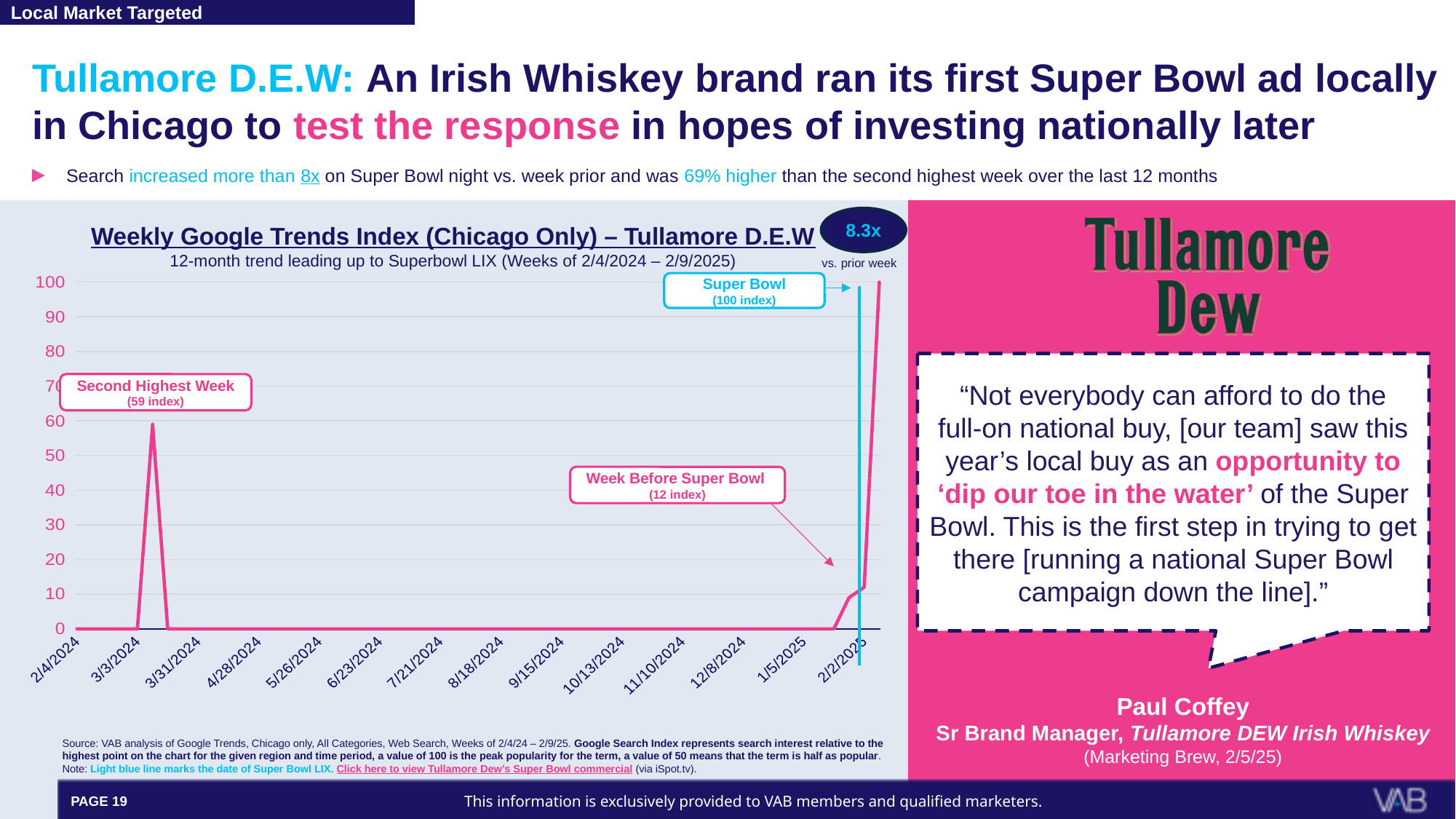
What is the index value for the week before the Super Bowl? 12 Which week has the highest Google Trends index value? Super Bowl week What is the difference between the Super Bowl week index and the second highest week index? 41 How many date labels are shown on the x axis? 14 What does the light blue vertical line on the chart mark? The date of Super Bowl LIX What is the index value for the second highest week? 59 What is the difference between the Super Bowl week index and the week before the Super Bowl? 88 How did the index values change between 4/28/2024 and 12/8/2024? Stayed flat near 0 Which is larger: the index for the second highest week or the index for the week before the Super Bowl? Second highest week What kind of chart is shown on the slide? Line chart What is the Google Trends index value for the Super Bowl week? 100 Is the index value for the week of 7/21/2024 greater or less than 10? less